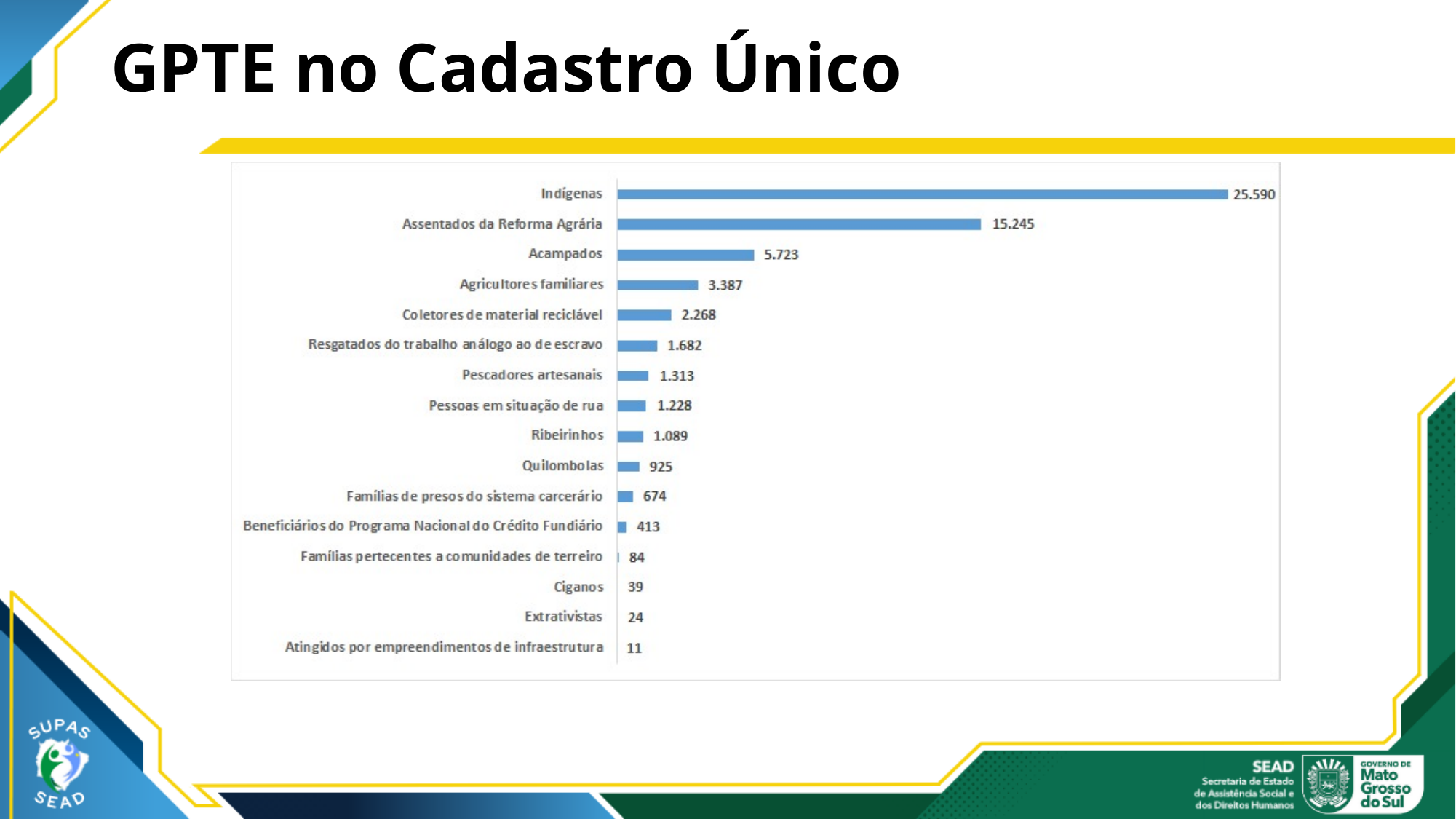
Which is larger, the value for Pescadores artesanais or the value for Ribeirinhos? Pescadores artesanais What is the value for Quilombolas? 925 What is the value for Extrativistas? 24 Which is larger, the value for Ciganos or the value for Famílias pertecentes a comunidades de terreiro? Famílias pertecentes a comunidades de terreiro Which category has the highest value? Indígenas What is the value for Indígenas? 25.590 Which category has the lowest value? Atingidos por empreendimentos de infraestrutura What is the difference between the values for Acampados and Agricultores familiares? 2.336 What is the value for Acampados? 5.723 What is the difference between the values for Indígenas and Assentados da Reforma Agrária? 10.345 How many categories are shown in the chart? 16 What kind of chart is shown on the slide? Bar chart